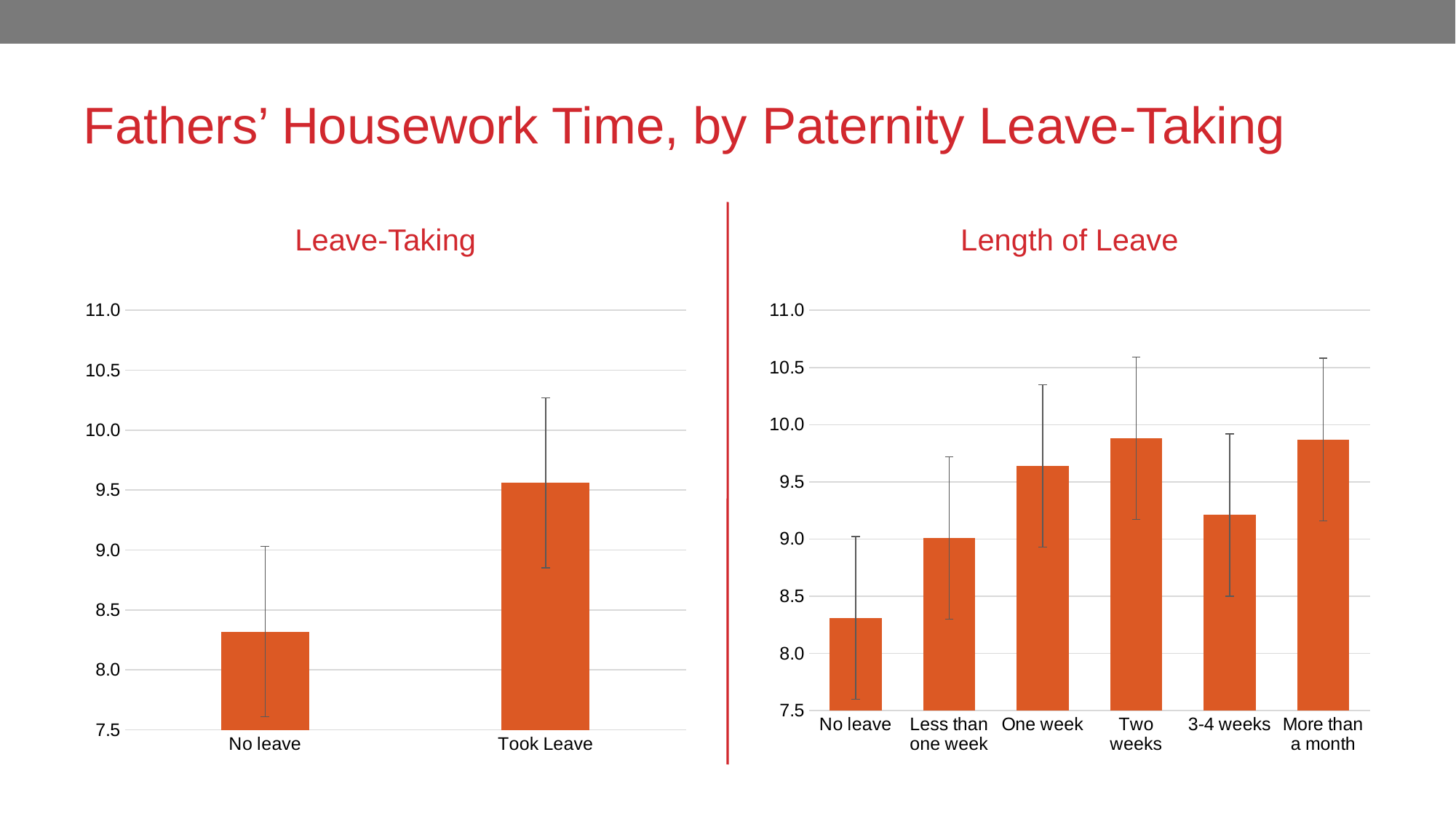
In the Leave-Taking chart, is the value for No leave greater or less than 8.5? less In the Leave-Taking chart, is the value for Took Leave greater or less than 9.0? greater In the Length of Leave chart, is the value for Less than one week greater or less than 8.5? greater How many categories are shown in the Leave-Taking chart? 2 How many categories are shown in the Length of Leave chart? 6 In the Length of Leave chart, which category has the lowest value? No leave In the Length of Leave chart, which is larger, the value for Two weeks or the value for 3-4 weeks? Two weeks What is the title of the slide containing the two charts? Fathers' Housework Time, by Paternity Leave-Taking In the Leave-Taking chart, which category has the higher value, No leave or Took Leave? Took Leave What kind of chart is the Leave-Taking chart? bar chart